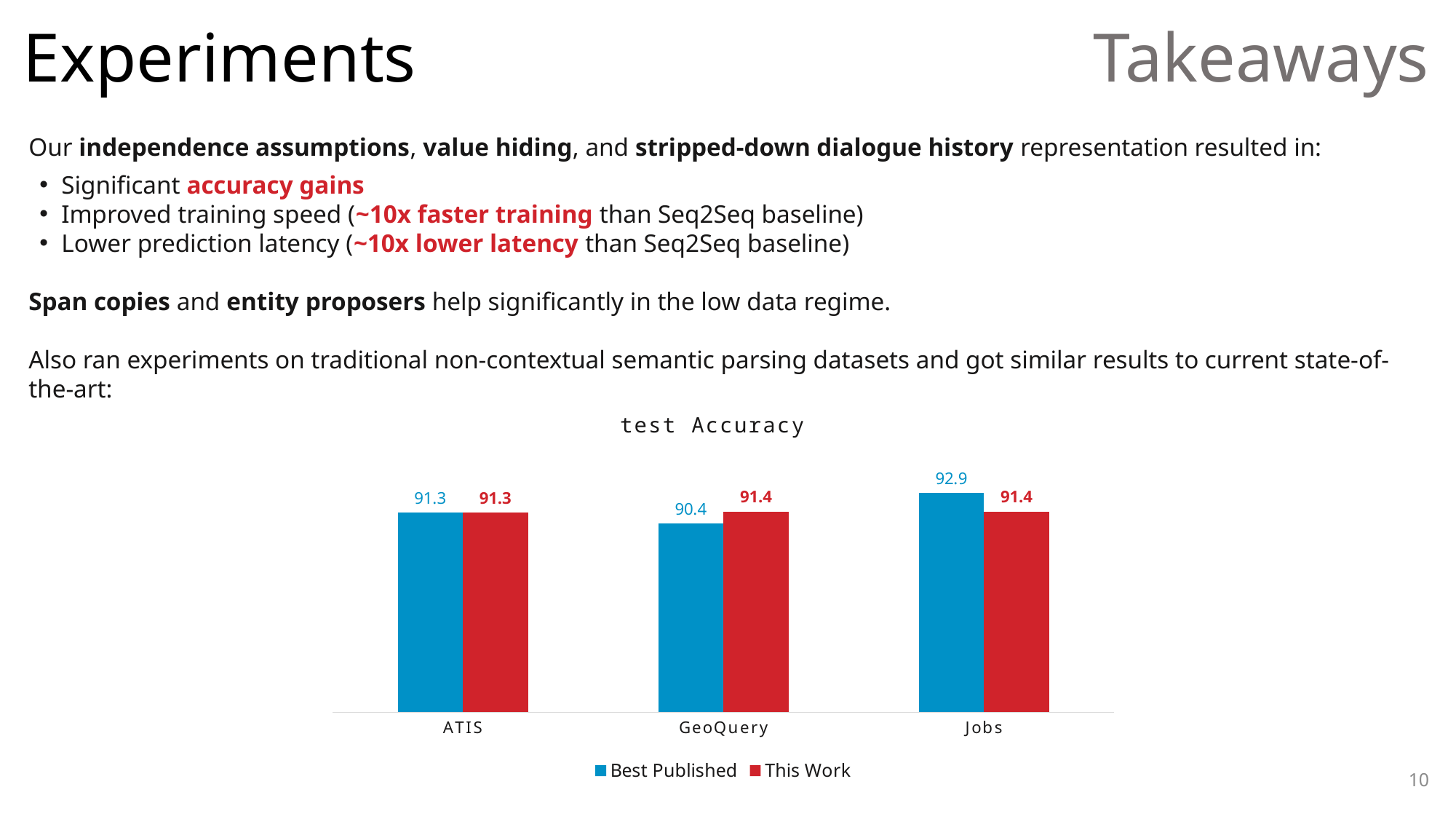
What is the Best Published test accuracy for Jobs? 92.9 What is the This Work test accuracy for ATIS? 91.3 What is the This Work test accuracy for Jobs? 91.4 On GeoQuery, which is larger: the Best Published or the This Work test accuracy? This Work What is the difference between the This Work and Best Published test accuracy on GeoQuery? 1.0 How many datasets are shown on the x axis of the chart? 3 Which dataset has the lowest Best Published test accuracy? GeoQuery How many series does the chart legend list? 2 What is the difference between the Best Published and This Work test accuracy on Jobs? 1.5 What kind of chart is shown on the slide? Bar chart What is the Best Published test accuracy for GeoQuery? 90.4 Which dataset has the highest Best Published test accuracy? Jobs